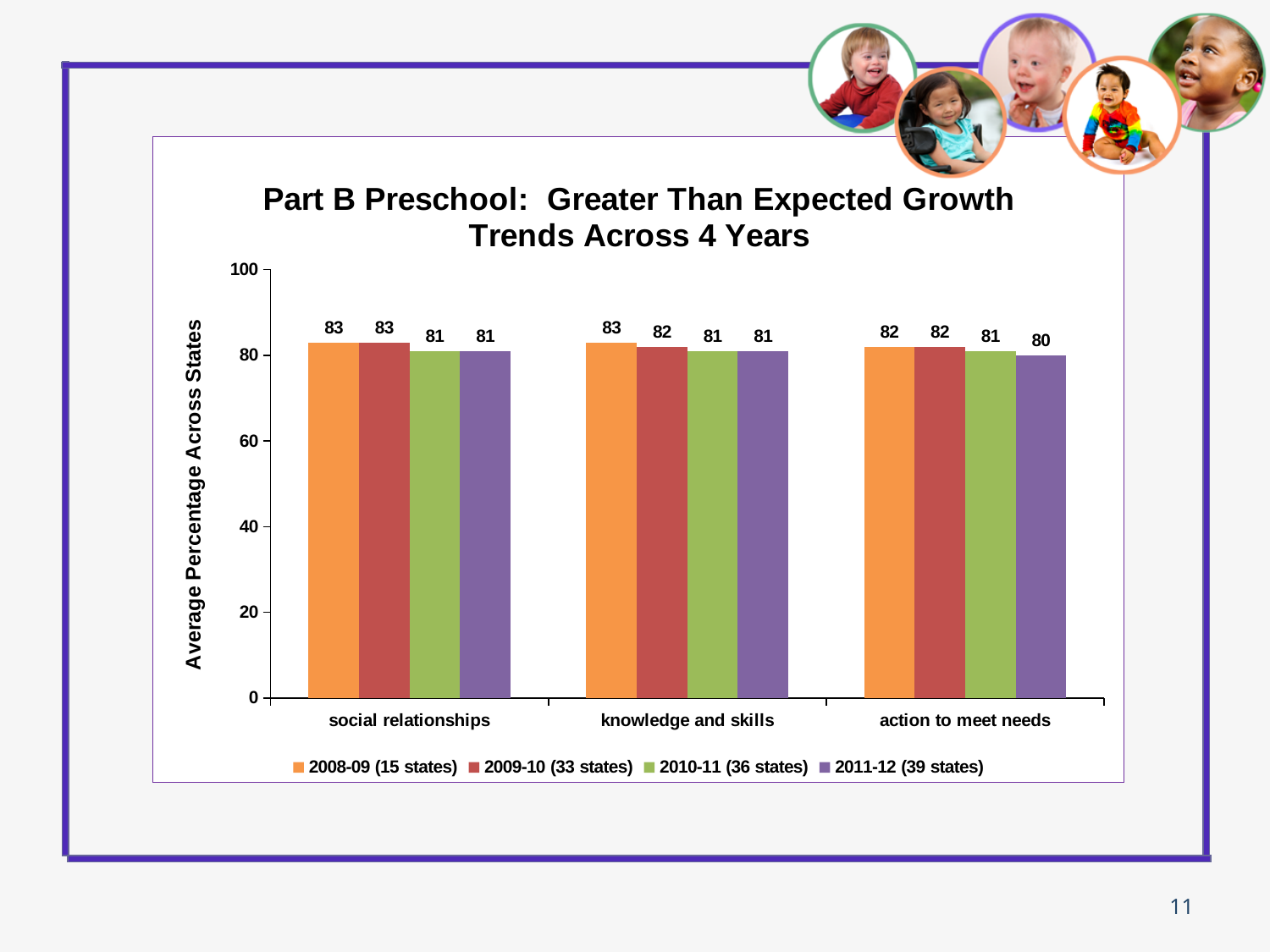
What is the value for 2011-12 (39 states) in the action to meet needs category? 80 What is the value for 2008-09 (15 states) in the social relationships category? 83 What is the title of the chart? Part B Preschool: Greater Than Expected Growth Trends Across 4 Years Which is larger: the 2008-09 (15 states) value for social relationships or the 2011-12 (39 states) value for action to meet needs? 2008-09 (15 states) value for social relationships What is the difference between the 2008-09 (15 states) and 2011-12 (39 states) values in the knowledge and skills category? 2 What is the value for 2010-11 (36 states) in the action to meet needs category? 81 What kind of chart is shown on the slide? bar chart How many series does the legend list? 4 Which series has the lowest value in the action to meet needs category? 2011-12 (39 states) Is the value for 2011-12 (39 states) in the social relationships category greater or less than 60? greater What is the value for 2009-10 (33 states) in the knowledge and skills category? 82 How many categories are shown on the x axis? 3